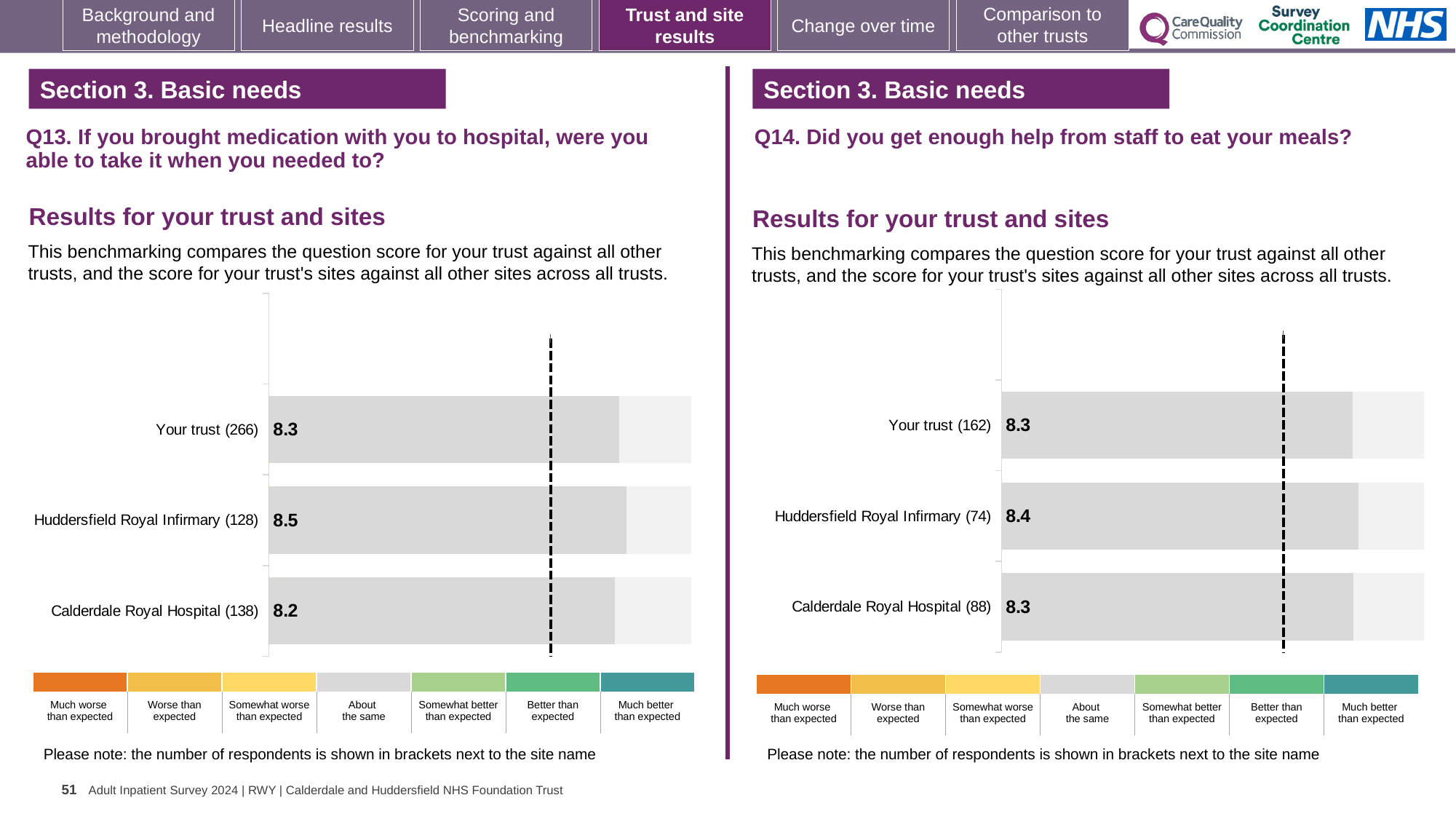
In the Q13 chart on the left, which site or trust has the highest score? Huddersfield Royal Infirmary In the Q13 chart on the left, what is the score for Huddersfield Royal Infirmary? 8.5 How many bars are plotted in the Q14 chart on the right? 3 In the Q13 chart on the left, which site or trust has the lowest score? Calderdale Royal Hospital In the Q13 chart on the left, how many respondents are shown for Your trust? 266 In the Q14 chart on the right, which site or trust has the highest score? Huddersfield Royal Infirmary In the Q13 chart on the left, what is the difference between the scores for Huddersfield Royal Infirmary and Calderdale Royal Hospital? 0.3 In the Q14 chart on the right, what is the score for Huddersfield Royal Infirmary? 8.4 What kind of chart is used in the Q13 chart on the left? Bar chart In the Q14 chart on the right, how many respondents are shown for Calderdale Royal Hospital? 88 In the Q14 chart on the right, what is the score for Your trust? 8.3 In the Q13 chart on the left, what is the score for Calderdale Royal Hospital? 8.2